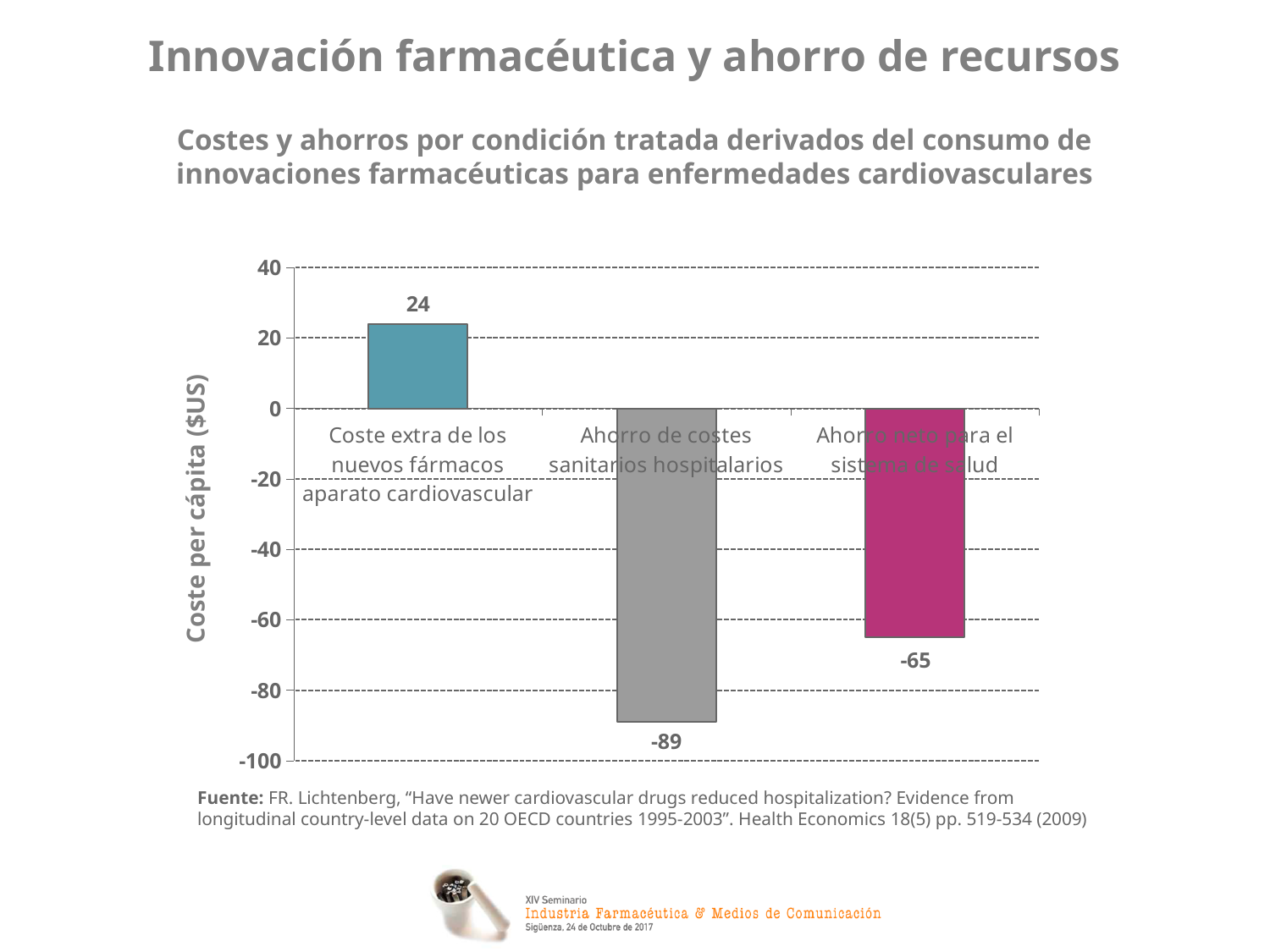
Which category has the lowest value? Ahorro de costes sanitarios hospitalarios What is the difference between the values for 'Ahorro de costes sanitarios hospitalarios' and 'Ahorro neto para el sistema de salud'? 24 Is the value for 'Ahorro de costes sanitarios hospitalarios' greater or less than -80? less What is the value for 'Ahorro de costes sanitarios hospitalarios'? -89 What is the label of the vertical axis? Coste per cápita ($US) What is the value for 'Ahorro neto para el sistema de salud'? -65 What is the value for 'Coste extra de los nuevos fármacos aparato cardiovascular'? 24 What kind of chart is shown on the slide? Bar chart Is the value for 'Coste extra de los nuevos fármacos aparato cardiovascular' greater or less than 20? greater Which category has the highest value? Coste extra de los nuevos fármacos aparato cardiovascular Which is larger, the value for 'Ahorro neto para el sistema de salud' or the value for 'Ahorro de costes sanitarios hospitalarios'? Ahorro neto para el sistema de salud How many categories are shown in the chart? 3